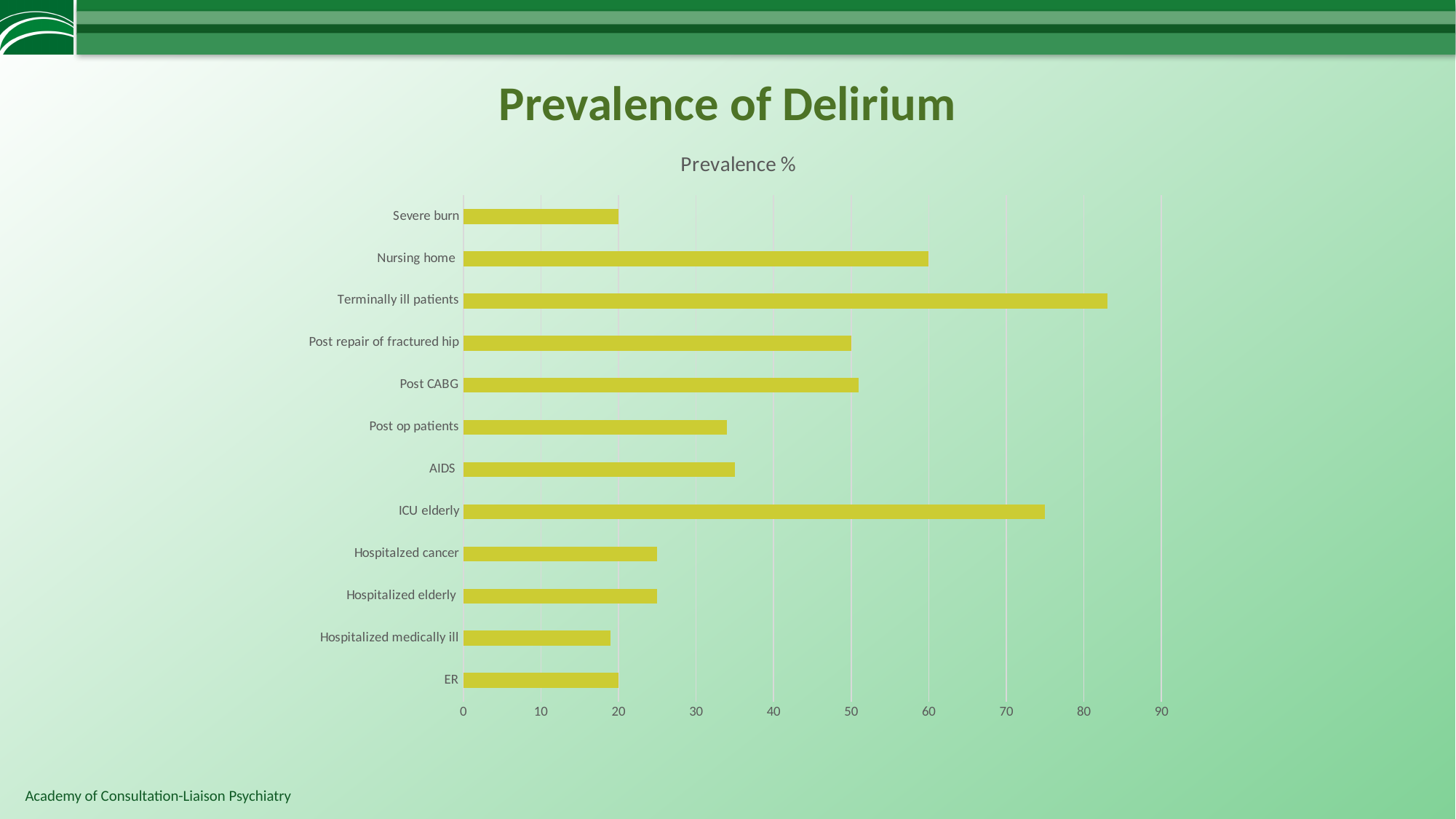
Which has a higher prevalence, Post op patients or Hospitalized cancer? Post op patients How many categories are plotted in the chart? 12 What is the difference between the prevalence for Nursing home and Severe burn? 40 What is the prevalence value for Post repair of fractured hip? 50 What type of chart is shown on the slide? Bar chart What is the prevalence value for Nursing home? 60 What is the prevalence value for Severe burn? 20 Which category has the highest prevalence? Terminally ill patients Is the value for ICU elderly greater or less than 70? greater Is the value for AIDS greater or less than 40? less What is the title of the chart? Prevalence % Which has a higher prevalence, ICU elderly or Nursing home? ICU elderly